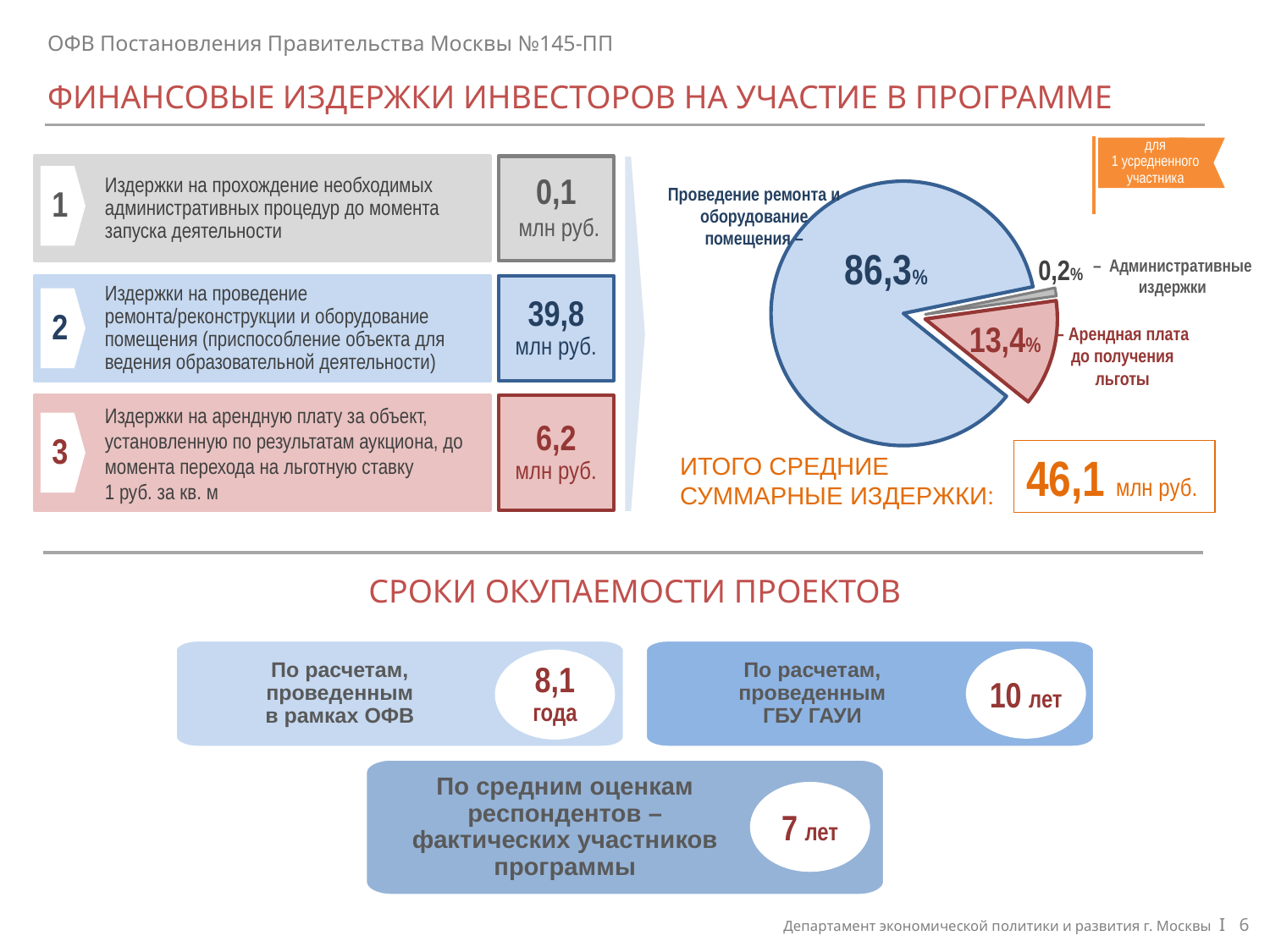
Which is larger in the pie chart: "Арендная плата до получения льготы" or "Административные издержки"? Арендная плата до получения льготы What share of the pie chart is labelled "Административные издержки"? 0,2% How many slices does the pie chart have? 3 What share of the pie chart is labelled "Арендная плата до получения льготы"? 13,4% Which slice of the pie chart is the largest? Проведение ремонта и оборудование помещения What colour is the largest slice of the pie chart? Light blue What is the difference in percentage points between the "Арендная плата до получения льготы" slice and the "Административные издержки" slice? 13,2 Which slice of the pie chart is the smallest? Административные издержки What kind of chart is shown on the slide? Pie chart What is the difference in percentage points between the "Проведение ремонта и оборудование помещения" slice and the "Арендная плата до получения льготы" slice? 72,9 What total value is shown next to the pie chart as "ИТОГО СРЕДНИЕ СУММАРНЫЕ ИЗДЕРЖКИ"? 46,1 млн руб. What share of the pie chart is labelled "Проведение ремонта и оборудование помещения"? 86,3%